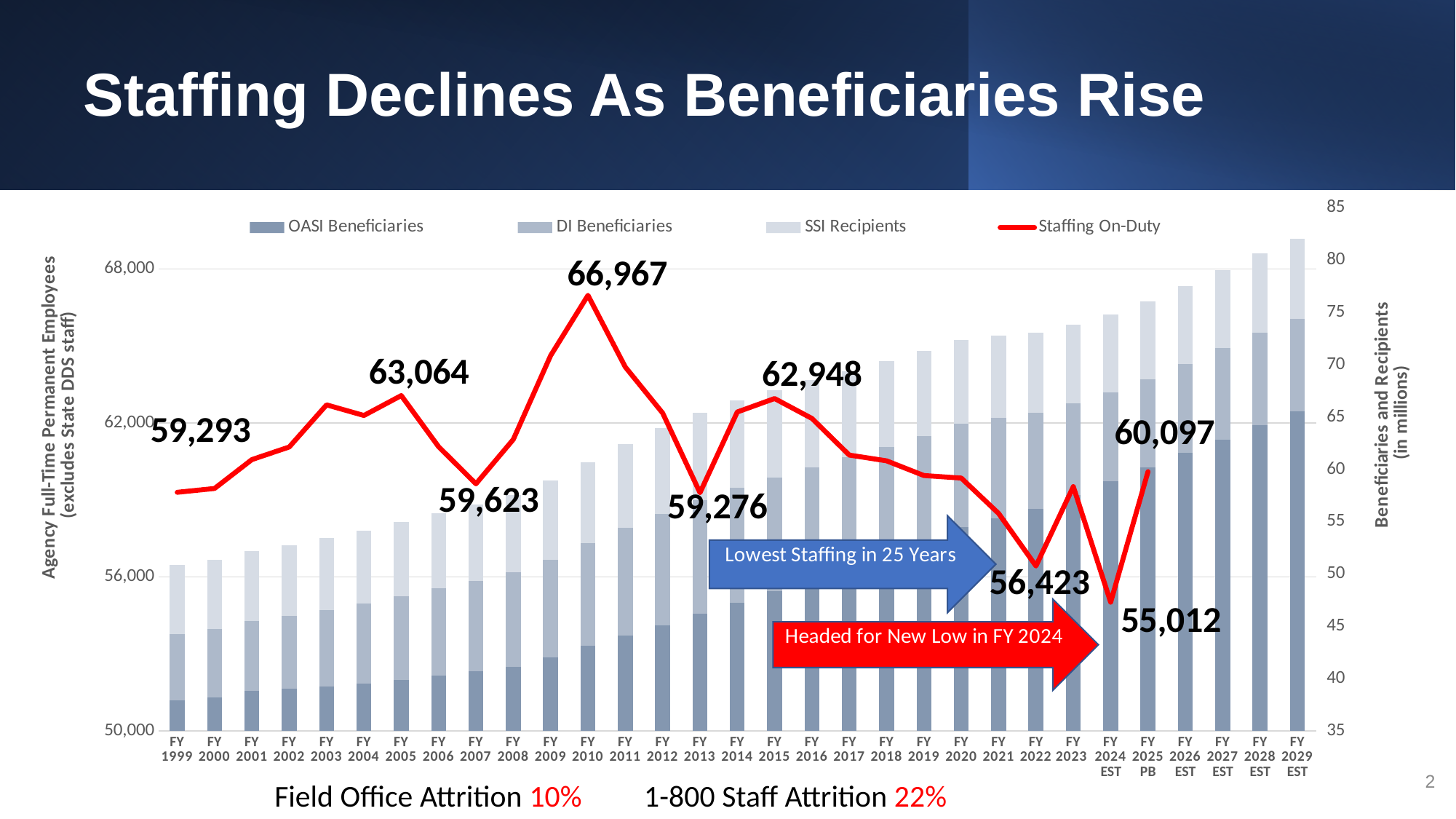
How many fiscal years are shown on the x axis? 31 How many series does the legend list? 4 In which fiscal year does the Staffing On-Duty line reach its highest labeled value? FY 2010 What is the Staffing On-Duty value for FY 1999? 59,293 What kind of chart is this? Combination stacked bar and line chart What is the Staffing On-Duty value for FY 2024 EST? 55,012 Is the Staffing On-Duty value for FY 2009 greater or less than 62,000? greater In which fiscal year does the Staffing On-Duty line reach its lowest labeled value? FY 2024 EST What is the difference between the Staffing On-Duty values for FY 2010 and FY 2024 EST? 11,955 Which year has the higher Staffing On-Duty value, FY 2005 or FY 2015? FY 2005 What is the Staffing On-Duty value for FY 2010? 66,967 How much higher is the Staffing On-Duty value for FY 2025 PB than for FY 2024 EST? 5,085